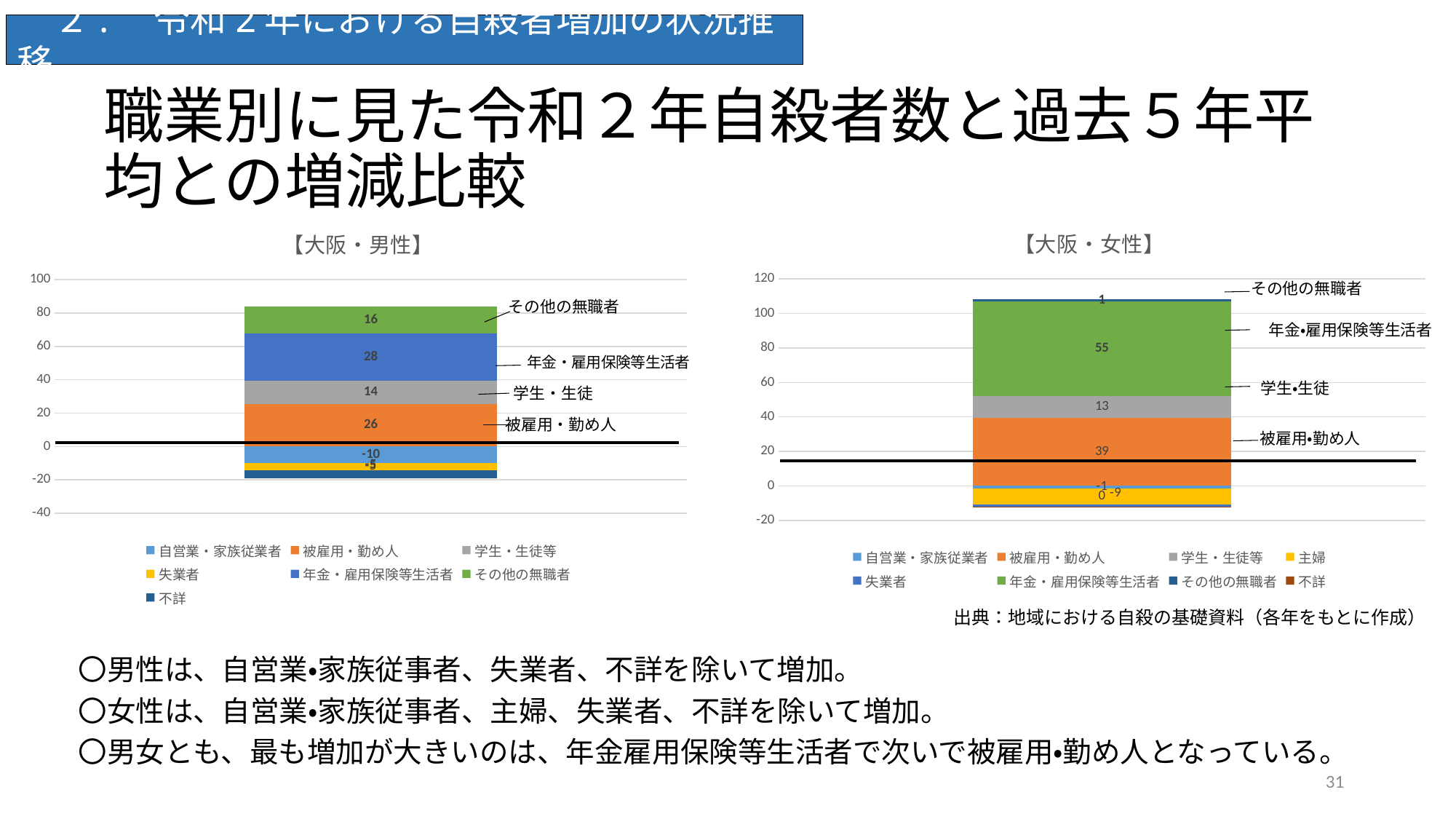
In the 【大阪・女性】 chart, what is the value for 被雇用・勤め人? 39 How many series does the legend of the 【大阪・男性】 chart list? 7 In the 【大阪・女性】 chart, which is larger, the value for 被雇用・勤め人 or the value for 学生・生徒? 被雇用・勤め人 In the 【大阪・男性】 chart, what is the difference between the values for 年金・雇用保険等生活者 and その他の無職者? 12 In the 【大阪・女性】 chart, what is the value for 年金・雇用保険等生活者? 55 How many series does the legend of the 【大阪・女性】 chart list? 8 In the 【大阪・男性】 chart, what is the value for 学生・生徒? 14 In the 【大阪・女性】 chart, what is the value for その他の無職者? 1 In the 【大阪・男性】 chart, what is the value for 被雇用・勤め人? 26 In the 【大阪・男性】 chart, what is the value for 年金・雇用保険等生活者? 28 In the 【大阪・男性】 chart, which labelled segment has the largest value? 年金・雇用保険等生活者 What kind of chart is the 【大阪・女性】 chart? Stacked bar chart